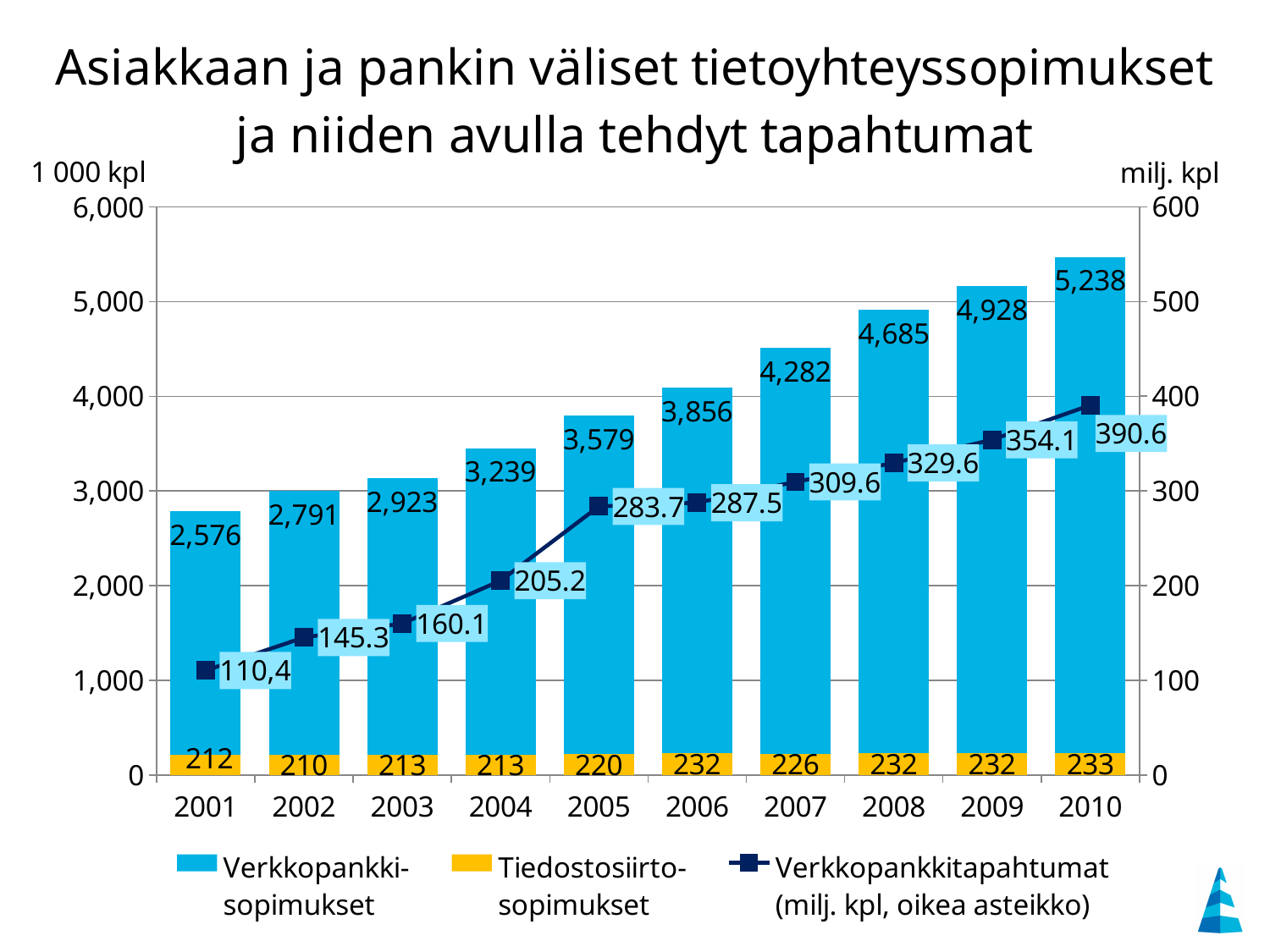
What kind of chart is this? Stacked bar chart with a line Which is larger, Verkkopankkitapahtumat in 2005 or in 2006? 2006 What is the value of Verkkopankkitapahtumat in 2004? 205.2 How many years are shown on the x axis? 10 How many series does the legend list? 3 What is the difference between Verkkopankkisopimukset in 2010 and in 2001? 2,662 In which year is Tiedostosiirtosopimukset lowest? 2002 What is the value of Verkkopankkisopimukset in 2010? 5,238 In which year is Verkkopankkisopimukset highest? 2010 What is the value of Tiedostosiirtosopimukset in 2005? 220 What is the total of the stacked bar for 2001? 2,788 Does Verkkopankkitapahtumat rise or fall from 2001 to 2010? Rise